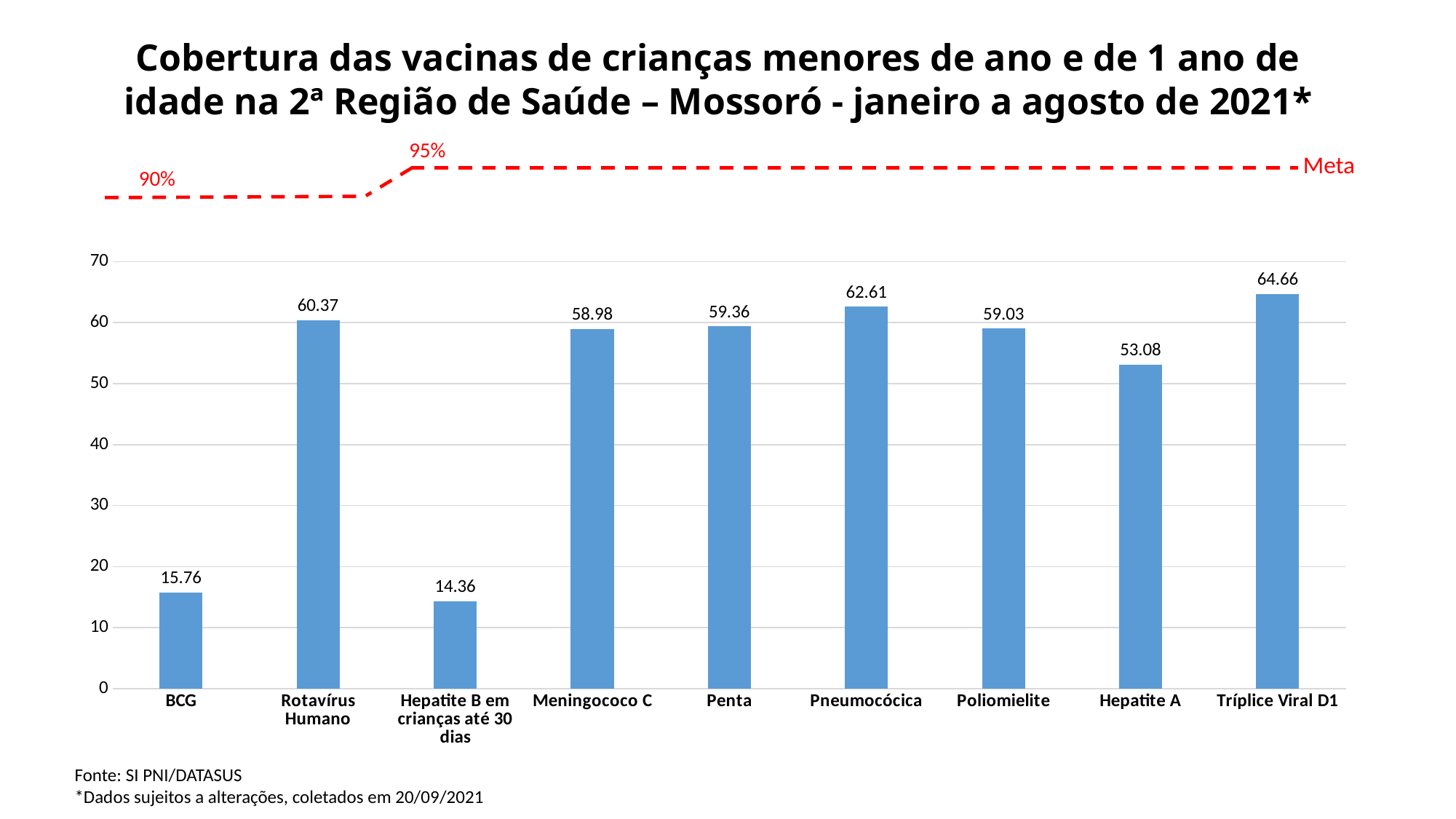
What is the source cited below the chart? SI PNI/DATASUS What is the difference between the values for Pneumocócica and Meningococo C? 3.63 How many vaccines are shown on the x axis? 9 Which vaccine has the lowest coverage value? Hepatite B em crianças até 30 dias Is the value for Poliomielite greater or less than 50? greater Which vaccine has the highest coverage value? Tríplice Viral D1 What is the value for Pneumocócica? 62.61 What is the difference between the values for Rotavírus Humano and BCG? 44.61 Which is larger, the value for Penta or the value for Hepatite A? Penta What is the value for Hepatite B em crianças até 30 dias? 14.36 What is the value for Tríplice Viral D1? 64.66 What kind of chart is shown on the slide? bar chart